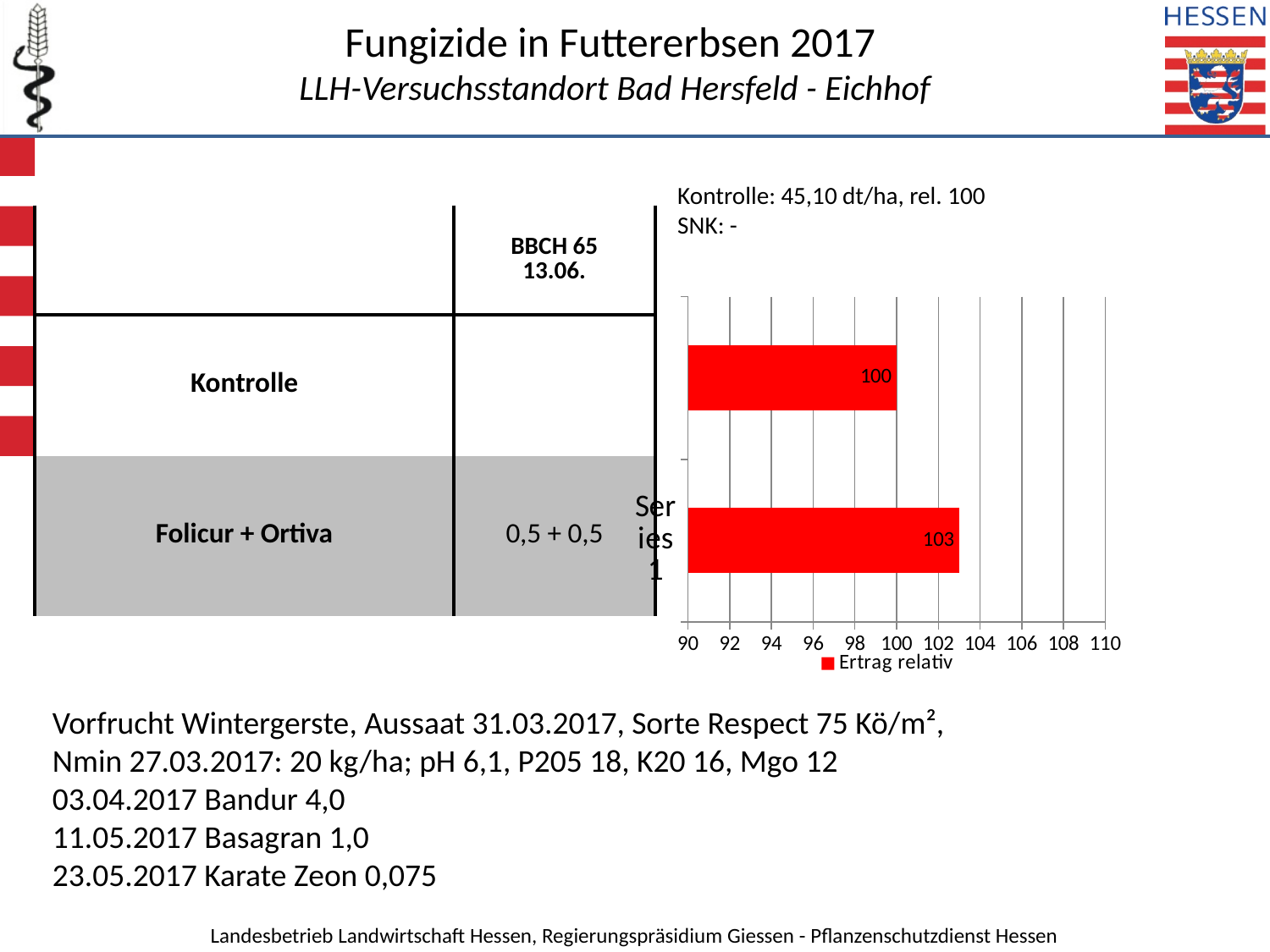
Which treatment has the lower relative yield bar? Kontrolle Is the relative yield bar for Folicur + Ortiva greater or less than 102? greater How many series does the chart legend list? 1 What is the name of the series shown in the chart legend? Ertrag relativ How many bars are plotted in the chart? 2 Which treatment has the higher relative yield, Kontrolle or Folicur + Ortiva? Folicur + Ortiva What is the relative yield (Ertrag relativ) value shown for Kontrolle? 100 By how much does the relative yield of Folicur + Ortiva exceed that of Kontrolle? 3 Is the relative yield bar for Kontrolle greater or less than 104? less What type of chart is shown on the slide? bar chart What colour are the bars in the chart? red What is the relative yield (Ertrag relativ) value shown for Folicur + Ortiva? 103